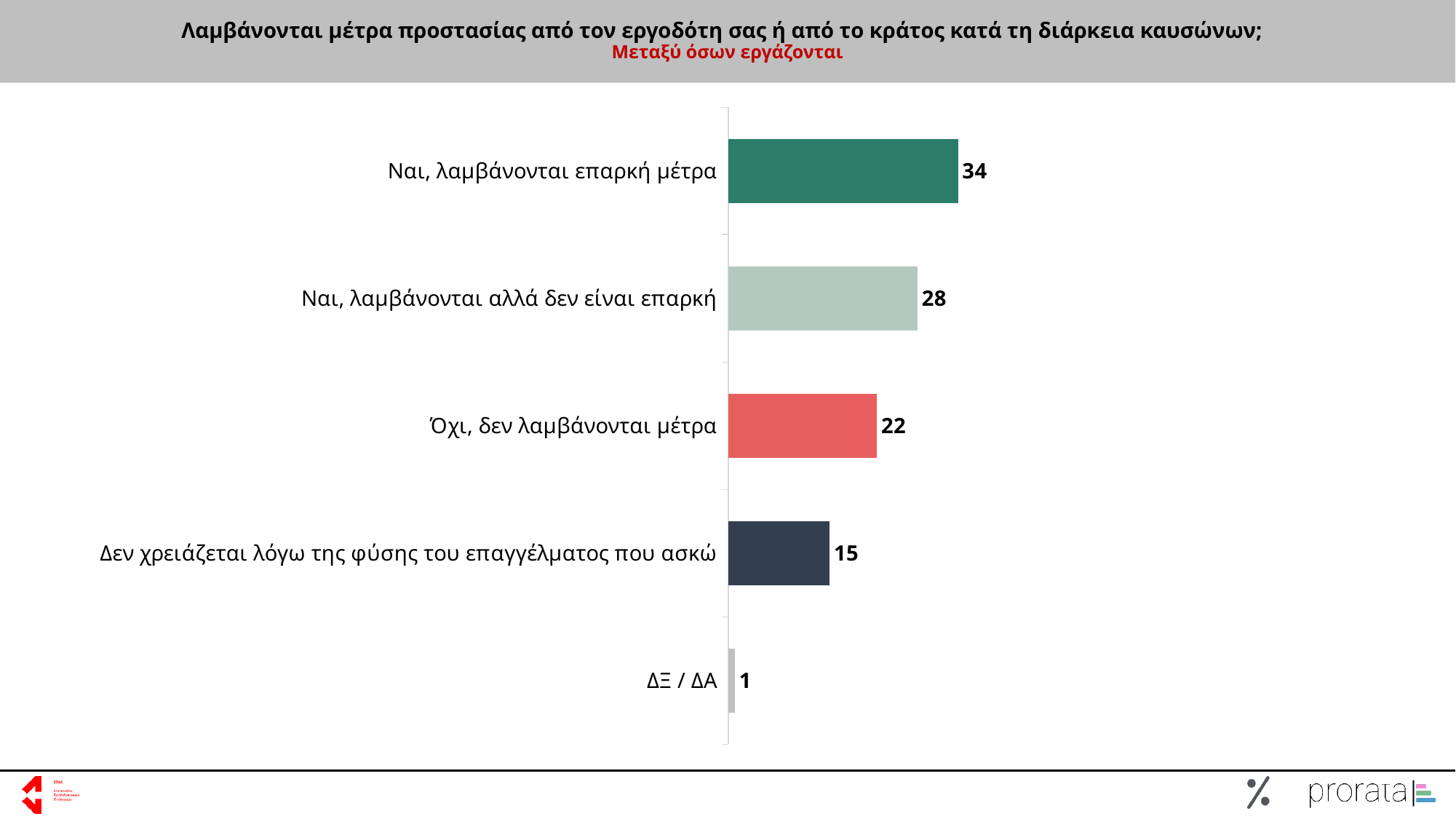
What is the value for "ΔΞ / ΔΑ"? 1 What is the value for "Δεν χρειάζεται λόγω της φύσης του επαγγέλματος που ασκώ"? 15 How many categories are shown in the chart? 5 What is the red subtitle text under the chart title? Μεταξύ όσων εργάζονται Which category has the highest value? Ναι, λαμβάνονται επαρκή μέτρα What kind of chart is shown on the slide? Bar chart What is the value for "Ναι, λαμβάνονται αλλά δεν είναι επαρκή"? 28 Which is larger: the value for "Ναι, λαμβάνονται αλλά δεν είναι επαρκή" or for "Δεν χρειάζεται λόγω της φύσης του επαγγέλματος που ασκώ"? Ναι, λαμβάνονται αλλά δεν είναι επαρκή What is the value for "Ναι, λαμβάνονται επαρκή μέτρα"? 34 What is the value for "Όχι, δεν λαμβάνονται μέτρα"? 22 Which category has the lowest value? ΔΞ / ΔΑ What is the difference between the values for "Ναι, λαμβάνονται επαρκή μέτρα" and "Όχι, δεν λαμβάνονται μέτρα"? 12